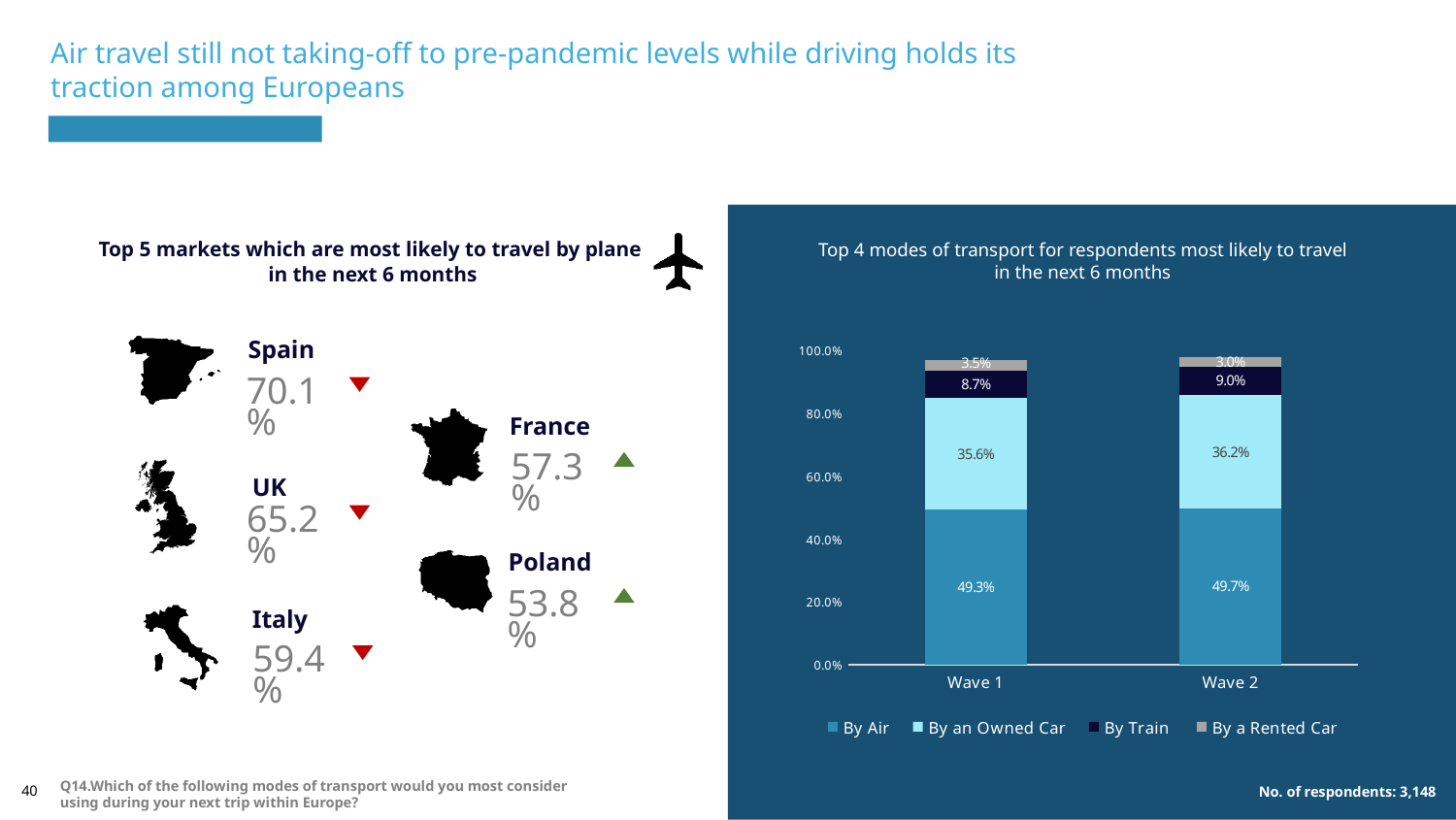
How many categories (waves) are shown on the x axis of the stacked bar chart? 2 In the stacked bar chart, which mode of transport has the smallest share in Wave 1? By a Rented Car In the stacked bar chart, is the By Air value larger in Wave 1 or Wave 2? Wave 2 In the stacked bar chart, what is the value for By Air in Wave 1? 49.3% In the stacked bar chart, what is the value for By a Rented Car in Wave 2? 3.0% What kind of chart is shown on the right side of the slide? Stacked bar chart In the stacked bar chart, does the By an Owned Car value rise or fall from Wave 1 to Wave 2? Rise In the stacked bar chart, what is the value for By an Owned Car in Wave 2? 36.2% In the stacked bar chart, what is the value for By Train in Wave 1? 8.7% How many series does the legend of the stacked bar chart list? 4 In the stacked bar chart, which mode of transport has the largest share in Wave 2? By Air In the stacked bar chart, what is the difference between the By Train value in Wave 2 and in Wave 1? 0.3%